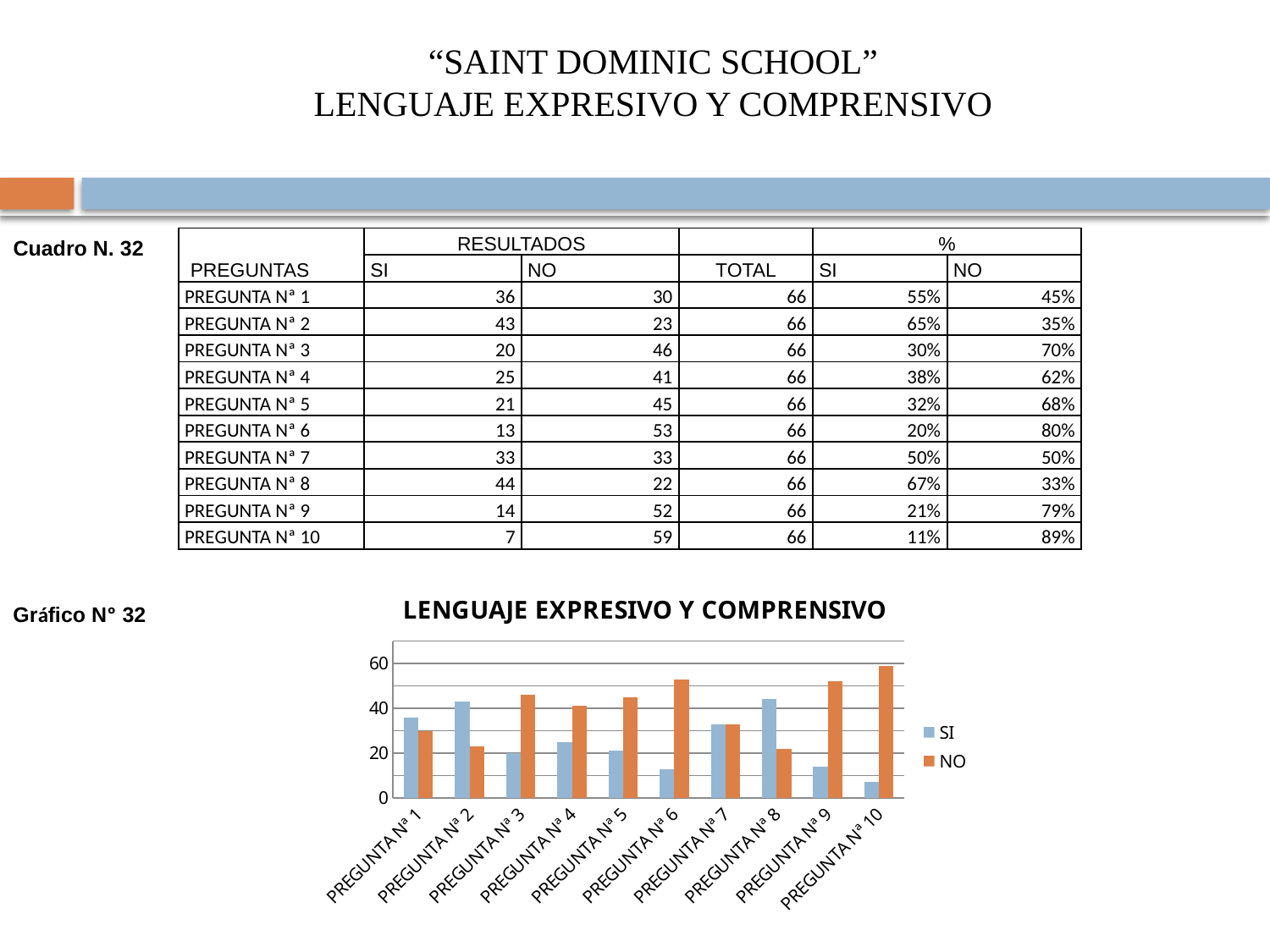
How many series does the chart legend list? 2 Is the NO value for PREGUNTA Nª 6 greater or less than 40? greater What is the SI value for PREGUNTA Nª 1 in the chart? 36 Which category has the lowest SI value in the chart? PREGUNTA Nª 10 What is the title of the chart? LENGUAJE EXPRESIVO Y COMPRENSIVO Is the SI value for PREGUNTA Nª 9 greater or less than 20? less Which category has the highest NO value in the chart? PREGUNTA Nª 10 What type of chart is shown on the slide? bar chart Which category has the highest SI value in the chart? PREGUNTA Nª 8 What is the difference between the NO and SI values for PREGUNTA Nª 10? 52 For PREGUNTA Nª 2, which is larger, SI or NO? SI How many categories (preguntas) are shown on the x axis of the chart? 10